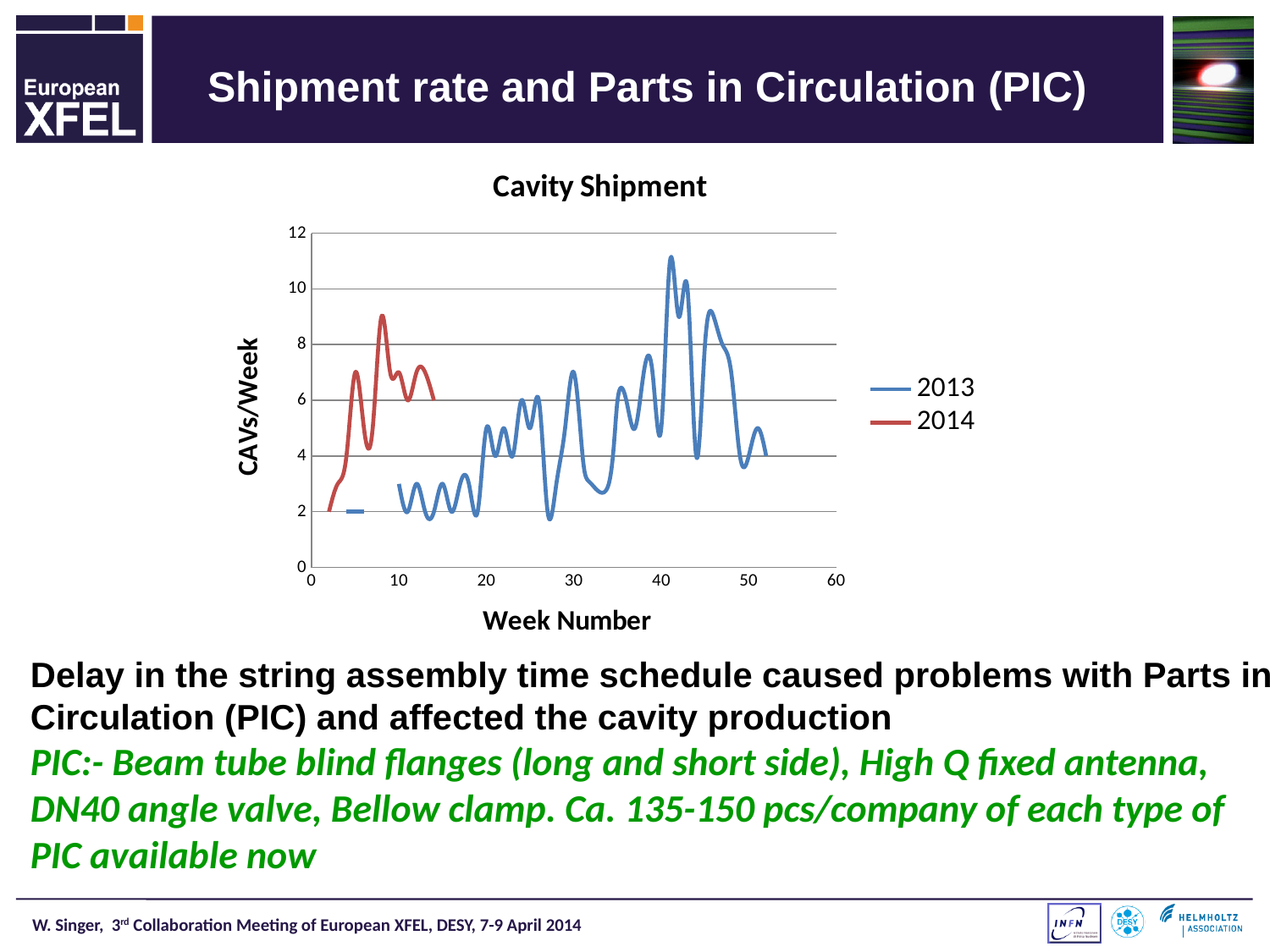
How many series does the legend of the Cavity Shipment chart list? 2 Which series has the higher value around week 8, 2013 or 2014? 2014 Which series extends to later week numbers on the x axis, 2013 or 2014? 2013 Is the peak value of the 2013 series greater or less than 10 CAVs/Week? greater Does the 2014 series rise or fall between week 2 and week 8? rise What kind of chart is shown on the slide? line chart Is the lowest value of the 2013 series greater or less than 4 CAVs/Week? less What is the label of the vertical axis? CAVs/Week Is the peak value of the 2014 series greater or less than 8 CAVs/Week? greater What is the title of the chart? Cavity Shipment Which series reaches the highest value on the chart, 2013 or 2014? 2013